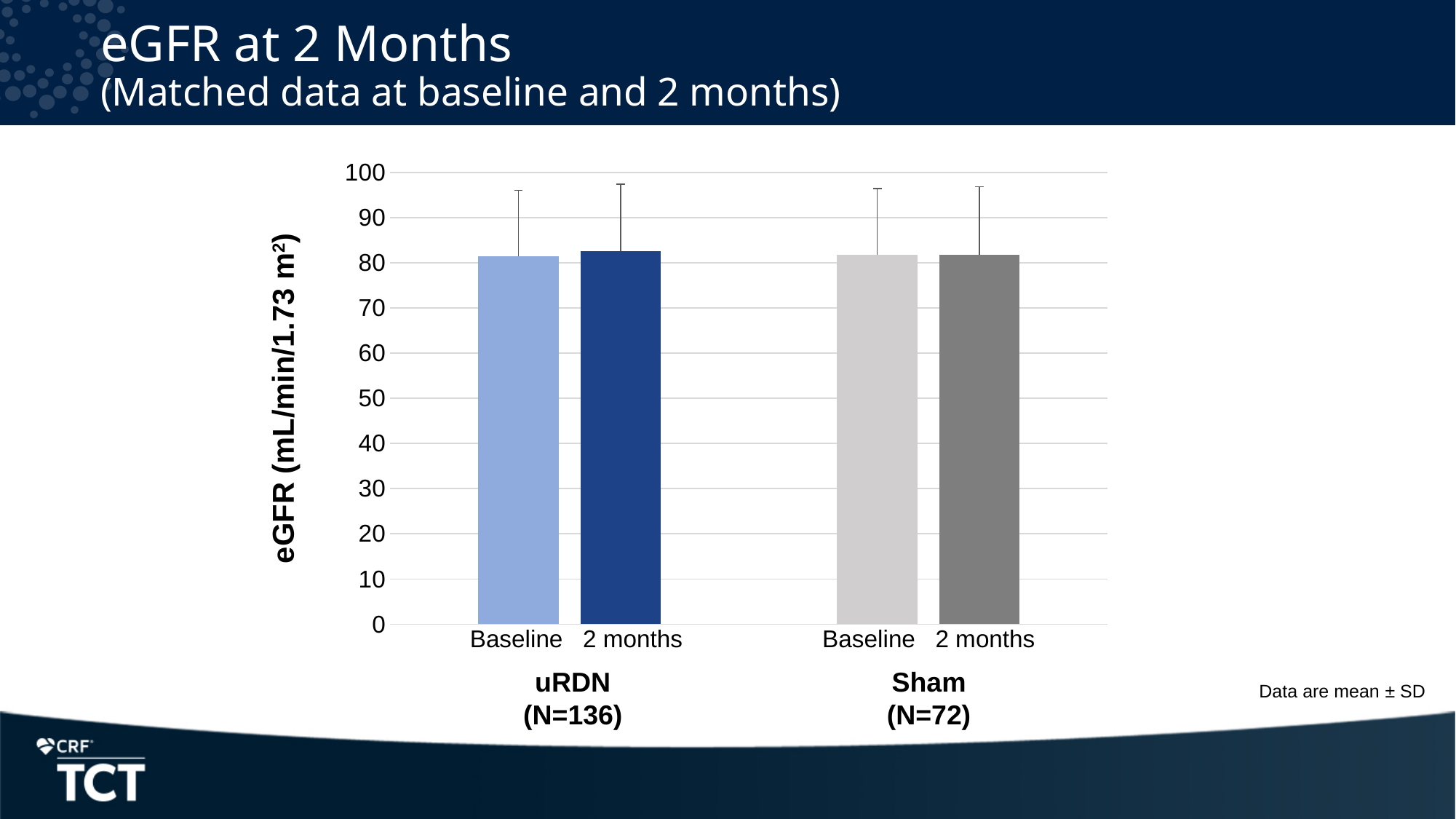
Is the value for Sham at 2 months greater or less than 90? less What kind of chart is shown on the slide? bar chart What is the sample size (N) shown for the Sham group? 72 Is the value for uRDN at Baseline greater or less than 70? greater What is the label of the y axis of the chart? eGFR (mL/min/1.73 m²) Is the value for Sham at Baseline greater or less than 70? greater How many bars are plotted in the chart? 4 What is the highest value shown on the y axis of the chart? 100 How many treatment groups are shown on the x axis of the chart? 2 What are the two time points shown for each group on the x axis? Baseline and 2 months What is the sample size (N) shown for the uRDN group? 136